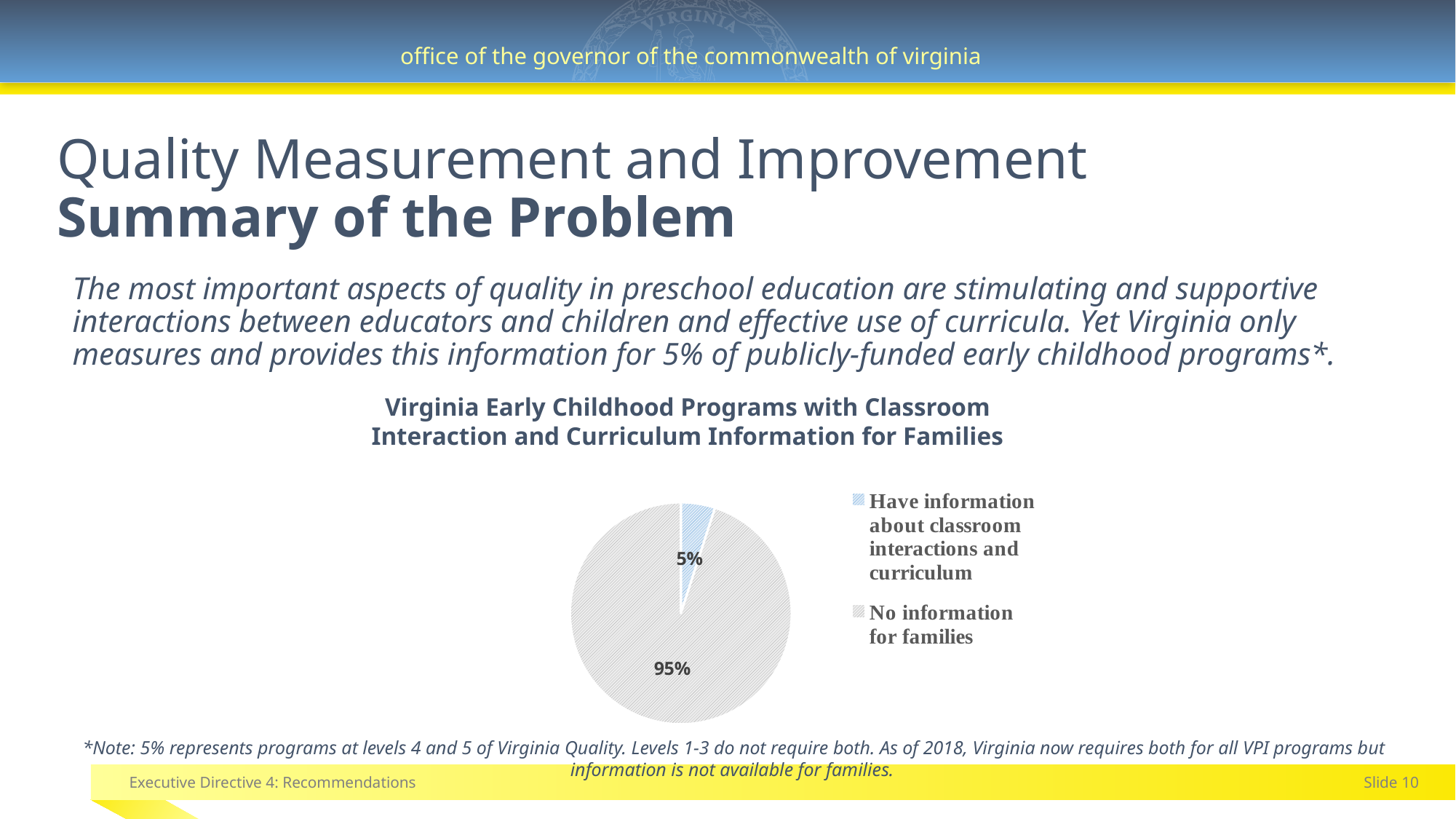
Which is larger: the share of programs with no information for families or the share with information about classroom interactions and curriculum? No information for families What share of the pie does the 'Have information about classroom interactions and curriculum' slice represent? 5% How many slices does the pie chart have? 2 What percentage of programs have no information for families? 95% What is the difference in percentage points between the 'No information for families' slice and the 'Have information about classroom interactions and curriculum' slice? 90 Which legend entry is shown in blue? Have information about classroom interactions and curriculum What percentage of programs have information about classroom interactions and curriculum? 5% How many entries does the legend list? 2 What kind of chart is shown on the slide? pie chart Which slice of the pie is the smallest? Have information about classroom interactions and curriculum What is the title of the pie chart? Virginia Early Childhood Programs with Classroom Interaction and Curriculum Information for Families Which slice of the pie is the largest? No information for families